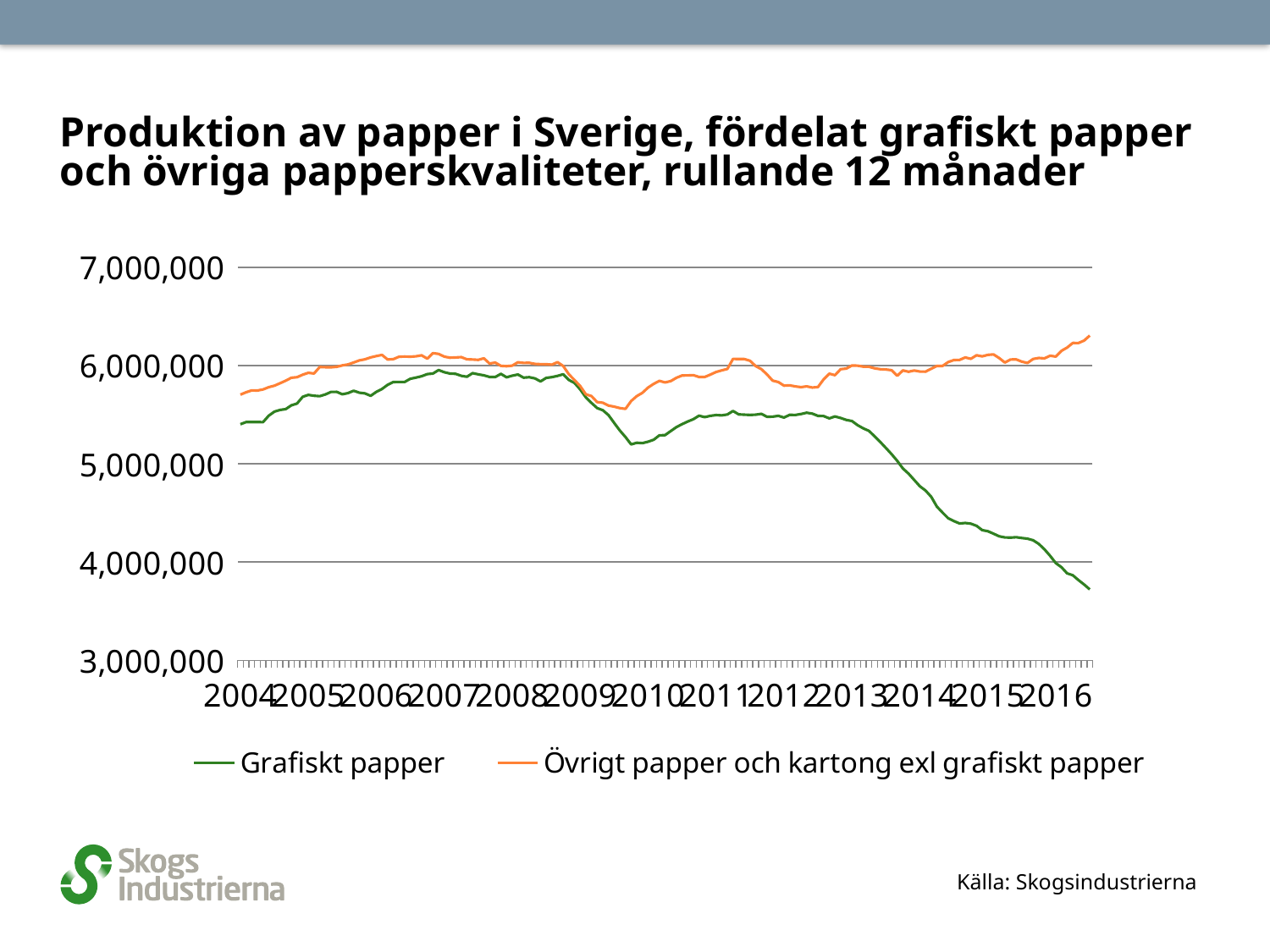
Is the value for Grafiskt papper at the start of 2004 greater or less than 5,000,000? greater Is the value for Övrigt papper och kartong exl grafiskt papper at the end of 2016 greater or less than 6,000,000? greater Does the Grafiskt papper series rise or fall between 2013 and 2016? fall Which series has the higher value at the end of 2016, Grafiskt papper or Övrigt papper och kartong exl grafiskt papper? Övrigt papper och kartong exl grafiskt papper Which series is plotted in green? Grafiskt papper Is the value for Övrigt papper och kartong exl grafiskt papper at the start of 2004 greater or less than 6,000,000? less What source is cited at the bottom of the slide? Skogsindustrierna How many year labels are shown on the x axis? 13 What kind of chart is shown on the slide? line chart Does the Övrigt papper och kartong exl grafiskt papper series rise or fall between 2014 and 2016? rise How many series does the legend list? 2